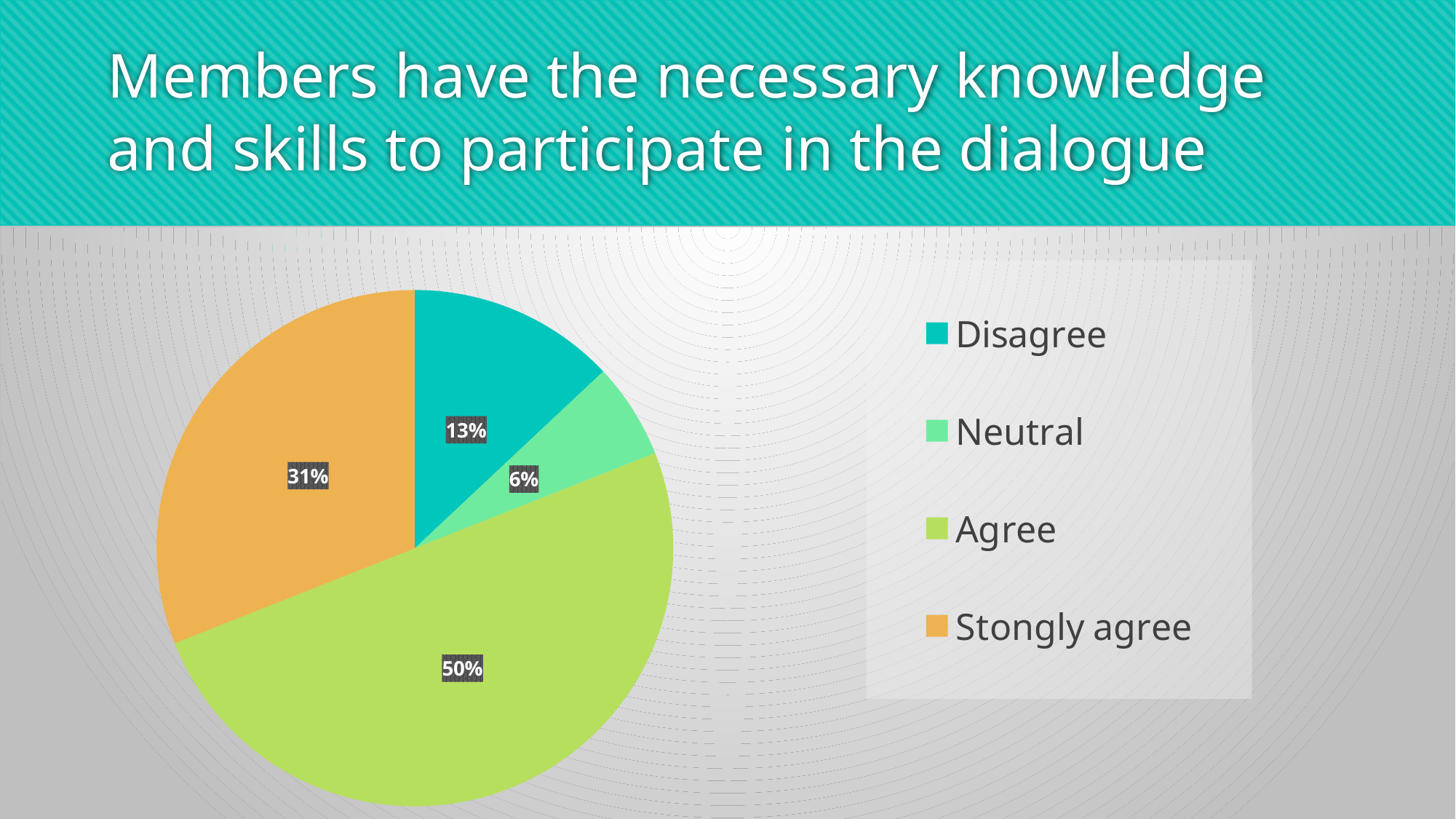
Which response category has the smallest share of the pie? Neutral What is the combined percentage of 'Agree' and 'Stongly agree'? 81% What type of chart is shown on the slide? Pie chart What colour is the 'Stongly agree' slice? Orange Which is larger, the share for 'Disagree' or the share for 'Neutral'? Disagree How many categories does the pie chart have? 4 What percentage of members responded 'Disagree'? 13% What is the difference in percentage points between 'Agree' and 'Stongly agree'? 19 What percentage of members responded 'Agree'? 50% What percentage of members responded 'Neutral'? 6% Which response category has the largest share of the pie? Agree What percentage of members responded 'Stongly agree'? 31%